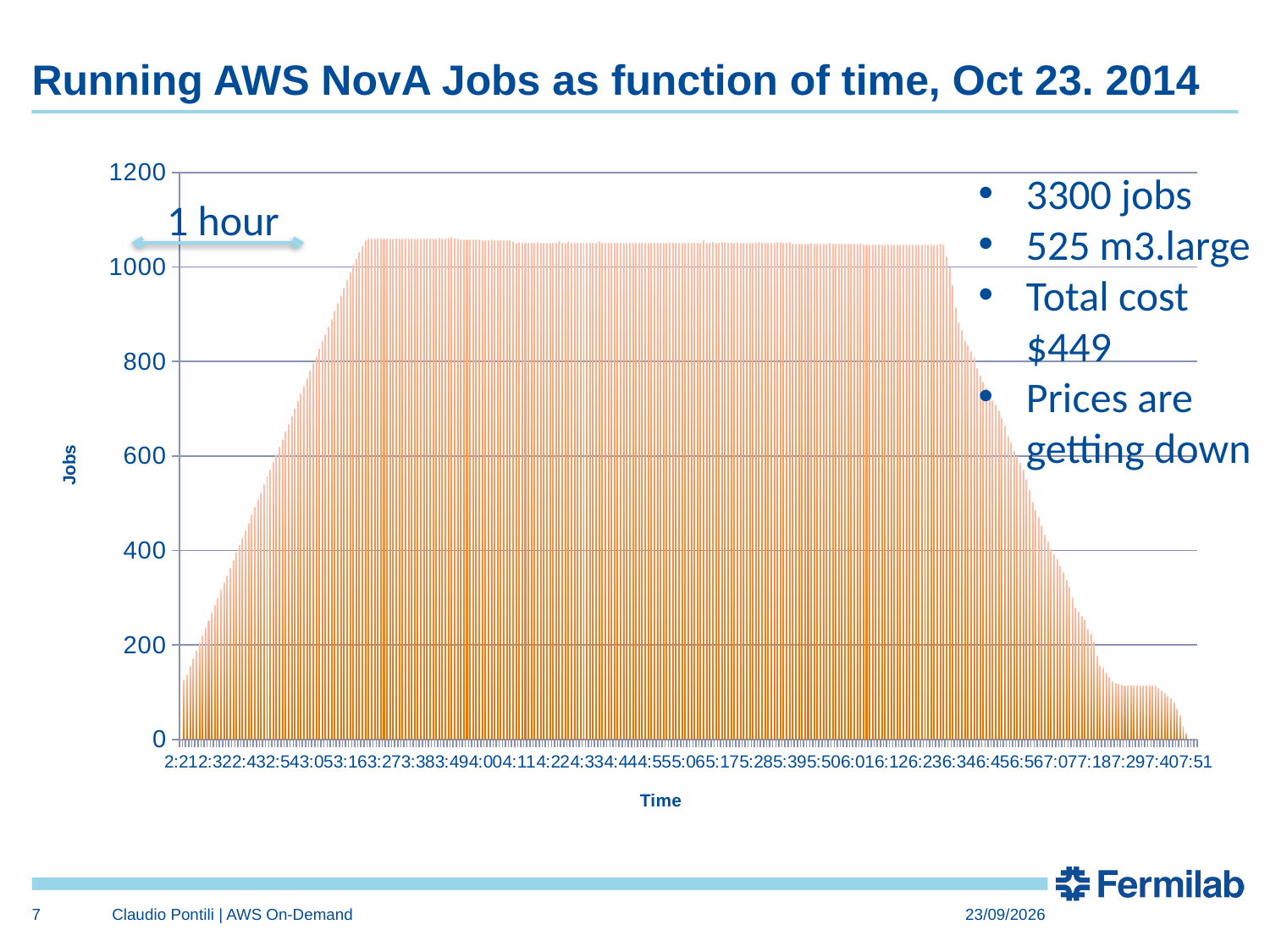
What is the title of the chart? Running AWS NovA Jobs as function of time, Oct 23. 2014 Do the values rise or fall along the x axis at the end of the chart? fall Do the values rise or fall along the x axis at the start of the chart? rise Is the number of jobs at the first time point on the left greater or less than 200? less What is the highest tick value shown on the vertical axis? 1200 Is the peak number of running jobs greater or less than 1000? greater What kind of chart is shown on the slide? bar chart Is the number of jobs at the last time point on the right greater or less than 200? less What is the label on the vertical axis of the chart? Jobs